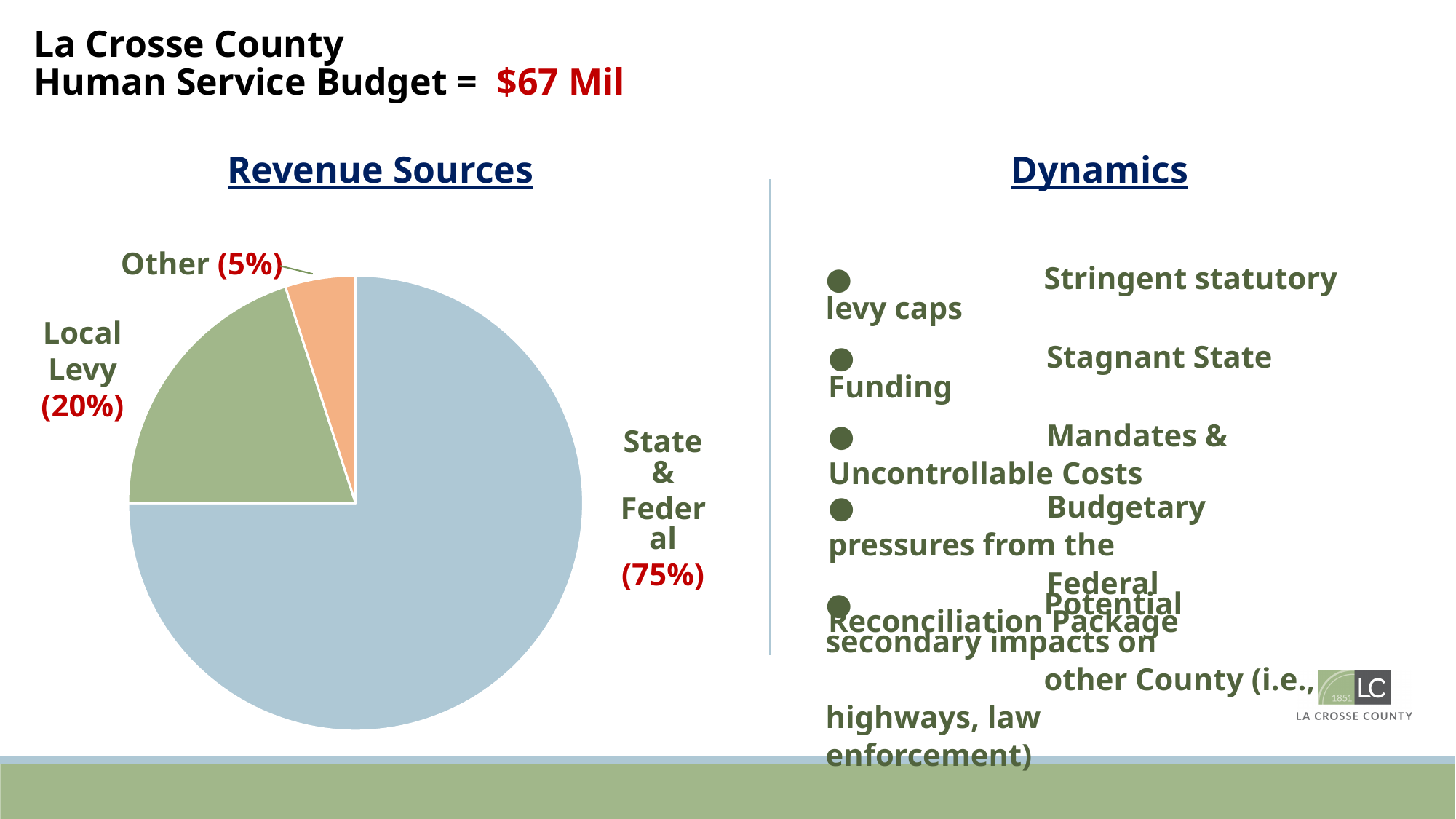
How many slices does the Revenue Sources pie chart have? 3 What share of revenue comes from the Local Levy? 20% What is the title of the pie chart? Revenue Sources What colour is the State & Federal slice of the pie? light blue Which is larger, the Local Levy share or the Other share? Local Levy How many percentage points larger is the State & Federal share than the Local Levy share? 55 What kind of chart is shown under Revenue Sources? pie chart What is the combined share of Local Levy and Other? 25% Which revenue source has the smallest share of the pie? Other Which revenue source has the largest share of the pie? State & Federal What share of revenue comes from State & Federal sources? 75% What share of revenue comes from Other sources? 5%